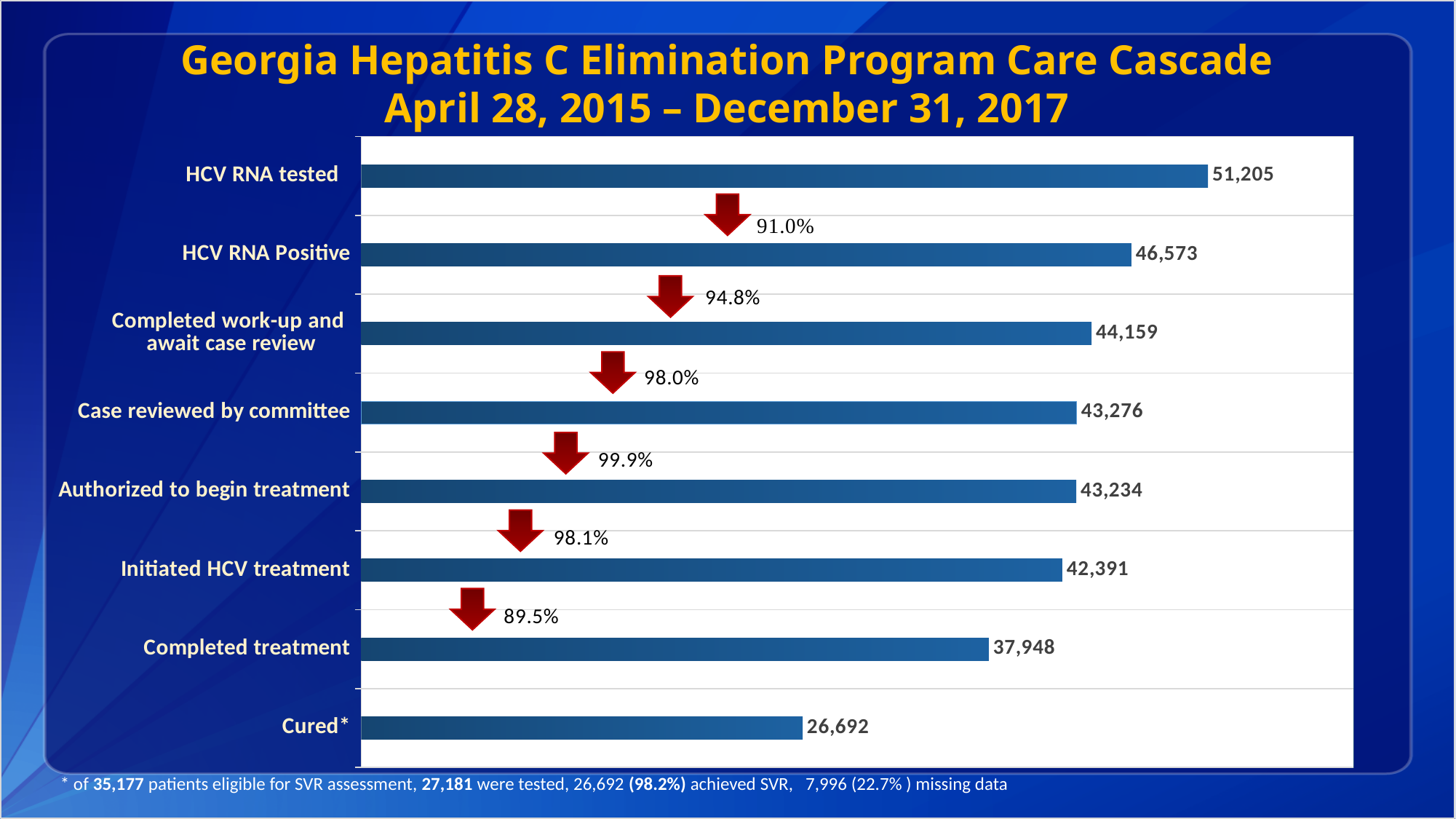
What is the difference between HCV RNA tested and HCV RNA Positive? 4,632 Do the values rise or fall going down the chart from HCV RNA tested to Cured*? Fall What is the difference between Initiated HCV treatment and Completed treatment? 4,443 Which category has the highest value? HCV RNA tested Which is larger, Case reviewed by committee or Authorized to begin treatment? Case reviewed by committee What is the value for Completed treatment? 37,948 How many categories are shown in the chart? 8 What percentage is shown next to the arrow between Completed treatment and Initiated HCV treatment? 89.5% What is the value for HCV RNA tested? 51,205 Which category has the lowest value? Cured* What kind of chart is shown on the slide? Bar chart What is the value for Cured*? 26,692